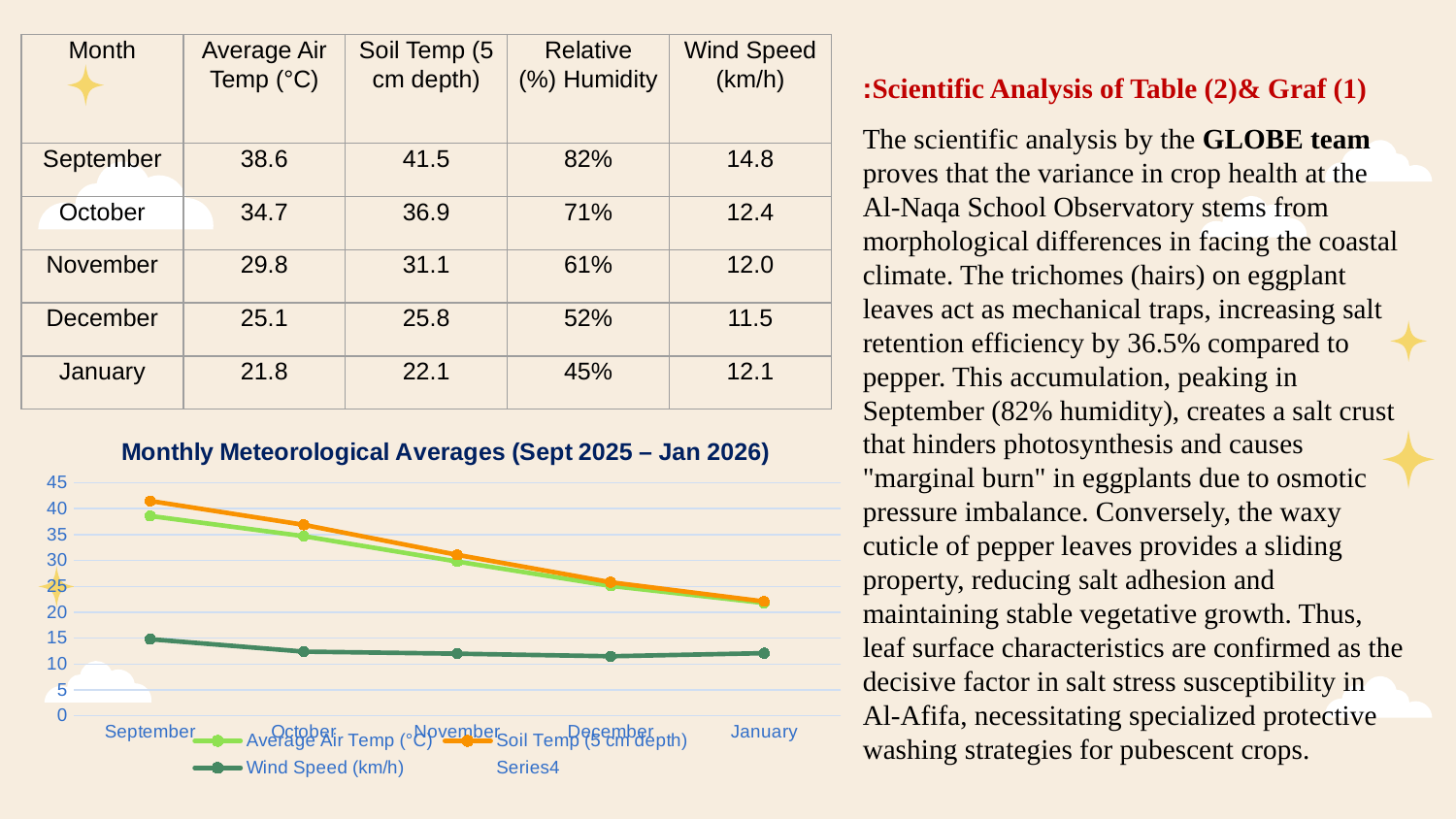
In the Monthly Meteorological Averages chart, which is higher in September: Soil Temp (5 cm depth) or Average Air Temp (°C)? Soil Temp (5 cm depth) In the Monthly Meteorological Averages chart, does the Average Air Temp (°C) line rise or fall from September to January? Fall What type of chart is shown under the title "Monthly Meteorological Averages (Sept 2025 – Jan 2026)"? Line chart In the Monthly Meteorological Averages chart, is the Wind Speed (km/h) value for January greater or less than 10? greater In the Monthly Meteorological Averages chart, is the Soil Temp (5 cm depth) value for October greater or less than 35? greater What is the name of the fourth legend entry in the Monthly Meteorological Averages chart? Series4 In the Monthly Meteorological Averages chart, which month has the highest Average Air Temp (°C)? September How many series does the legend of the Monthly Meteorological Averages chart list? 4 How many months are plotted along the x axis of the Monthly Meteorological Averages chart? 5 In the Monthly Meteorological Averages chart, is the Average Air Temp (°C) value for January greater or less than 25? less In the Monthly Meteorological Averages chart, which month has the lowest Soil Temp (5 cm depth)? January